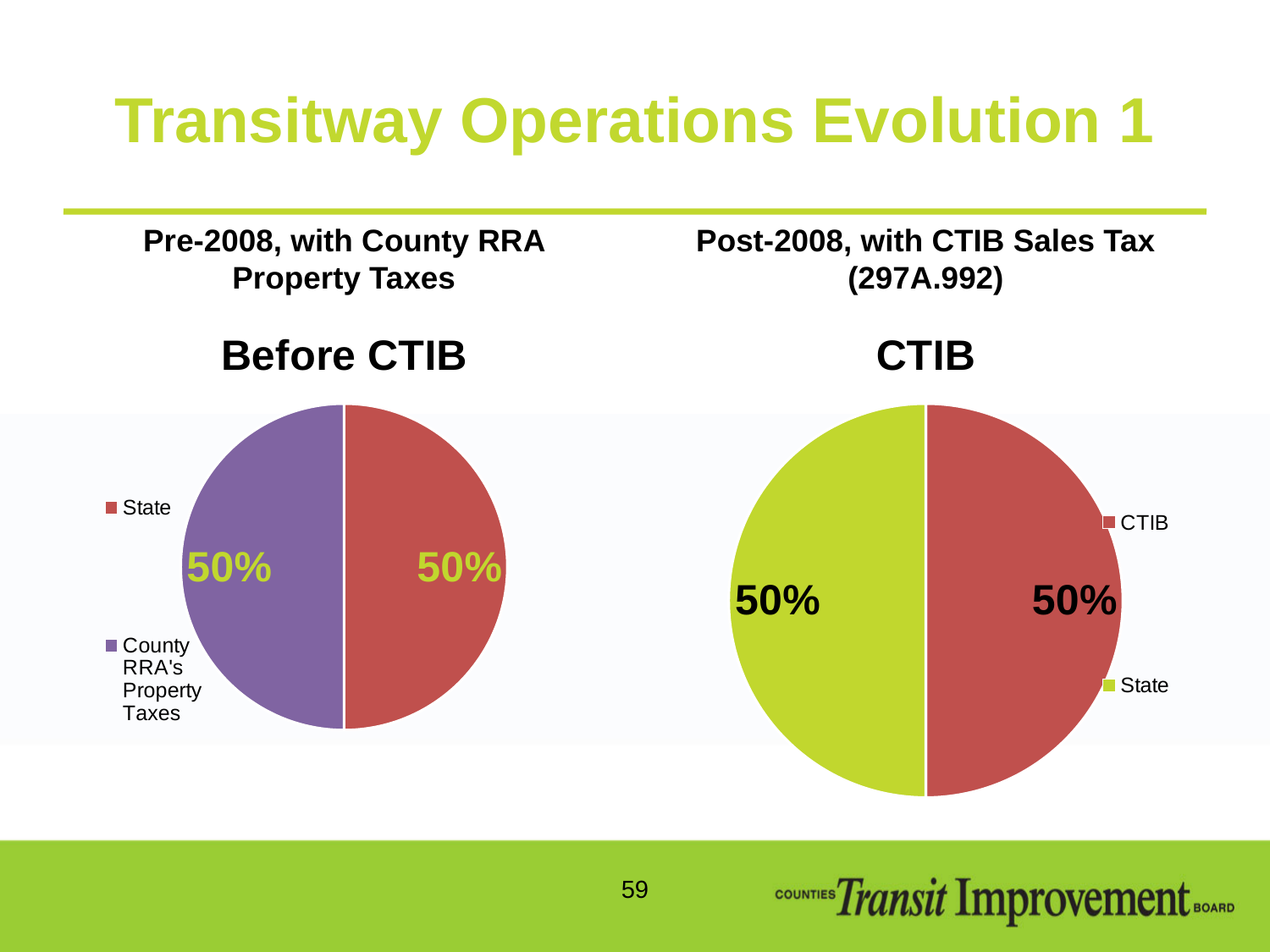
What kind of chart is the 'Before CTIB' chart? Pie chart How many slices does the 'Before CTIB' chart have? 2 In the 'CTIB' chart, what is the total of the CTIB and State shares? 100% In the 'CTIB' chart, what share does CTIB have? 50% What are the two legend entries in the 'CTIB' chart? CTIB and State What kind of chart is the 'CTIB' chart? Pie chart What is the title of the pie chart on the left side of the slide? Before CTIB In the 'Before CTIB' chart, what is the difference between the State share and the County RRA's Property Taxes share? 0% How many slices does the 'CTIB' chart have? 2 In the 'Before CTIB' chart, what share does County RRA's Property Taxes have? 50% In the 'CTIB' chart, what share does State have? 50%